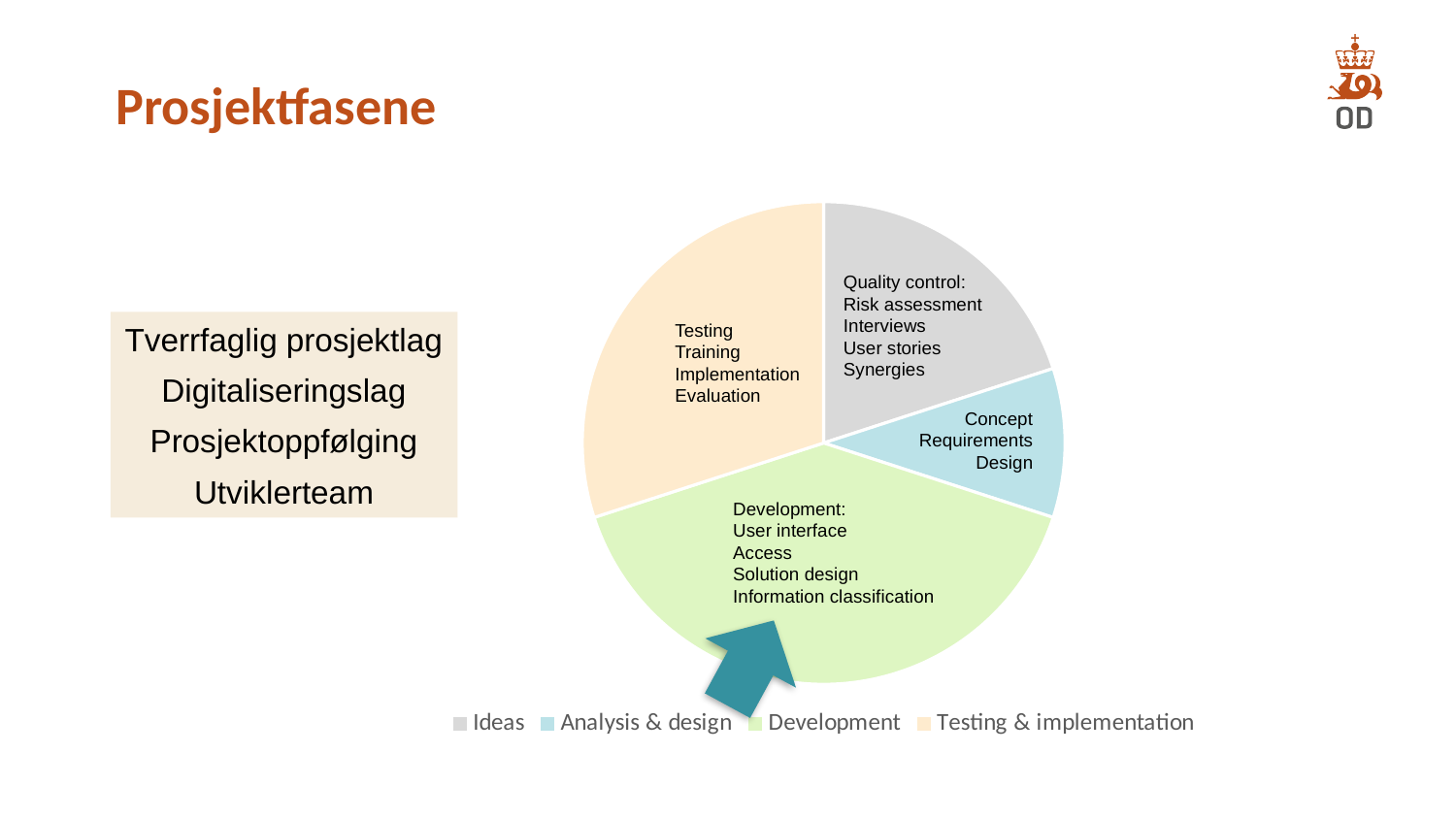
Which slice is larger, Ideas or Analysis & design? Ideas Which slice is larger, Development or Testing & implementation? Development What kind of chart is shown on the slide? pie chart What colour is the Development slice of the pie chart? green How many entries does the legend of the pie chart list? 4 How many slices does the pie chart have? 4 Which slice of the pie chart is the largest? Development Which slice is larger, Testing & implementation or Ideas? Testing & implementation Which slice of the pie chart is the smallest? Analysis & design Which legend entry corresponds to the grey slice of the pie chart? Ideas